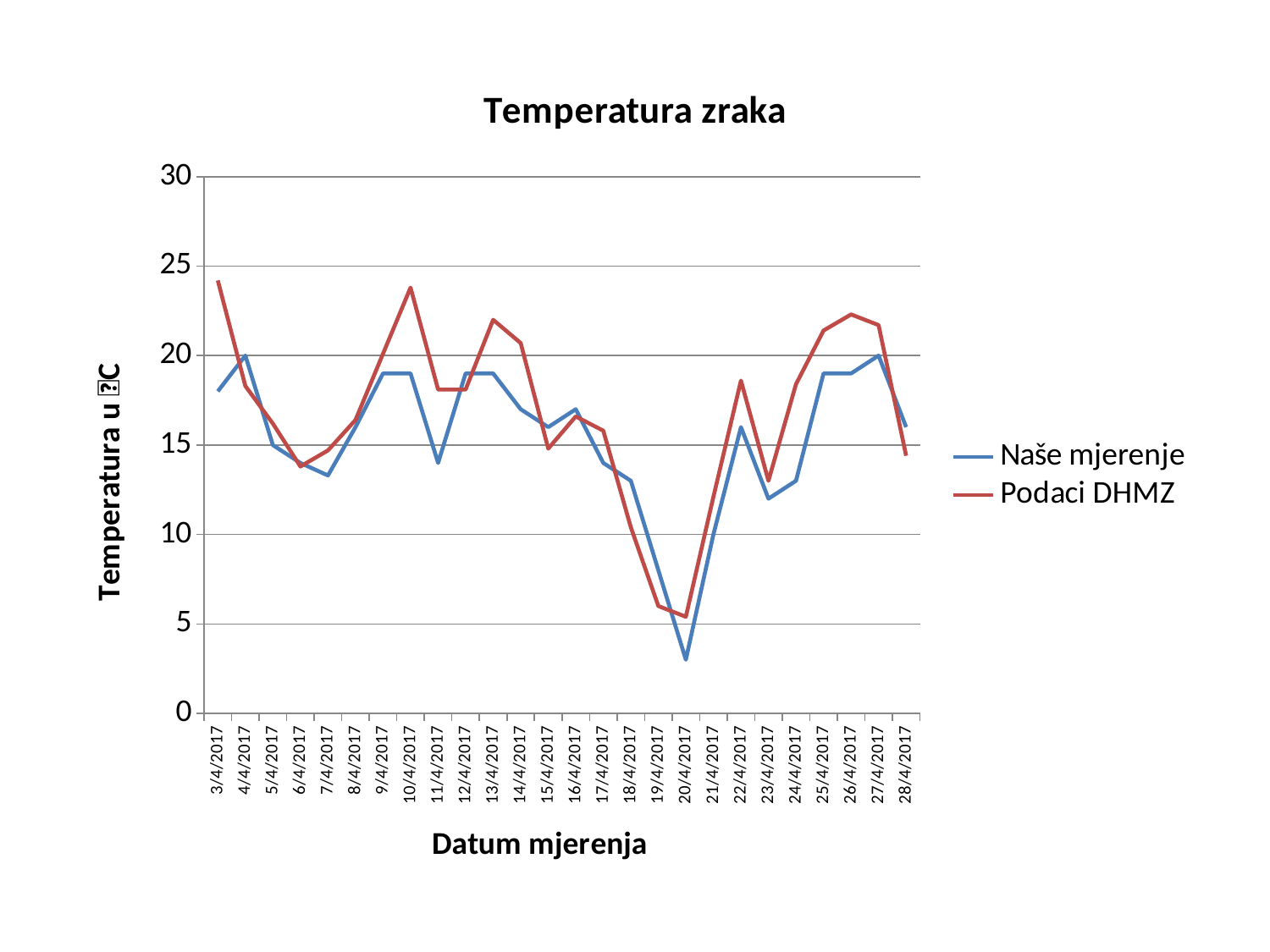
Is the 'Naše mjerenje' value on 23/4/2017 greater or less than 15? less What kind of chart is shown on the slide? line chart Does the 'Naše mjerenje' series rise or fall between 17/4/2017 and 20/4/2017? fall What is the label of the x axis? Datum mjerenja How many dates are plotted along the x axis? 26 What is the title of the chart? Temperatura zraka Is the 'Naše mjerenje' value on 20/4/2017 greater or less than 5? less On 4/4/2017, which series has the higher value, 'Naše mjerenje' or 'Podaci DHMZ'? Naše mjerenje On which date does the 'Naše mjerenje' series reach its lowest value? 20/4/2017 Is the 'Podaci DHMZ' value on 3/4/2017 greater or less than 20? greater How many series does the legend list? 2 On 10/4/2017, which series has the higher value, 'Naše mjerenje' or 'Podaci DHMZ'? Podaci DHMZ